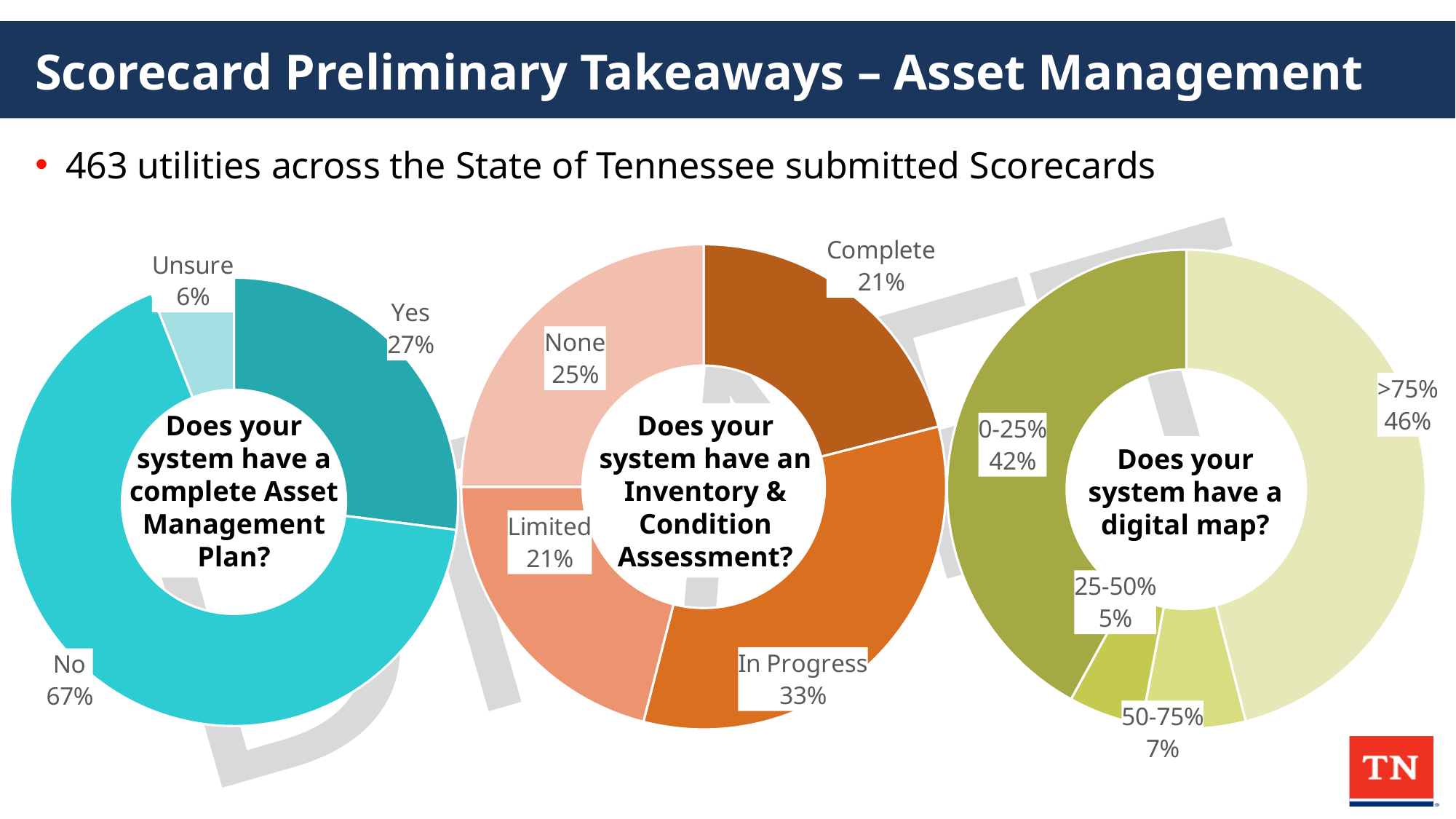
In the 'Does your system have a complete Asset Management Plan?' chart, which response has the largest share? No In the 'Does your system have an Inventory & Condition Assessment?' chart, which response has the largest share? In Progress What type of chart is used for the 'Does your system have a digital map?' chart? Doughnut chart In the 'Does your system have a digital map?' chart, which is larger: the share for 0-25% or the share for 50-75%? 0-25% In the 'Does your system have a complete Asset Management Plan?' chart, what percentage answered No? 67% In the 'Does your system have an Inventory & Condition Assessment?' chart, what percentage answered None? 25% In the 'Does your system have a digital map?' chart, what percentage answered >75%? 46% In the 'Does your system have an Inventory & Condition Assessment?' chart, what percentage answered In Progress? 33% How many categories are shown in the 'Does your system have an Inventory & Condition Assessment?' chart? 4 In the 'Does your system have a complete Asset Management Plan?' chart, what is the difference between the No and Yes shares? 40% In the 'Does your system have a complete Asset Management Plan?' chart, what percentage answered Unsure? 6% In the 'Does your system have a digital map?' chart, which response has the smallest share? 25-50%